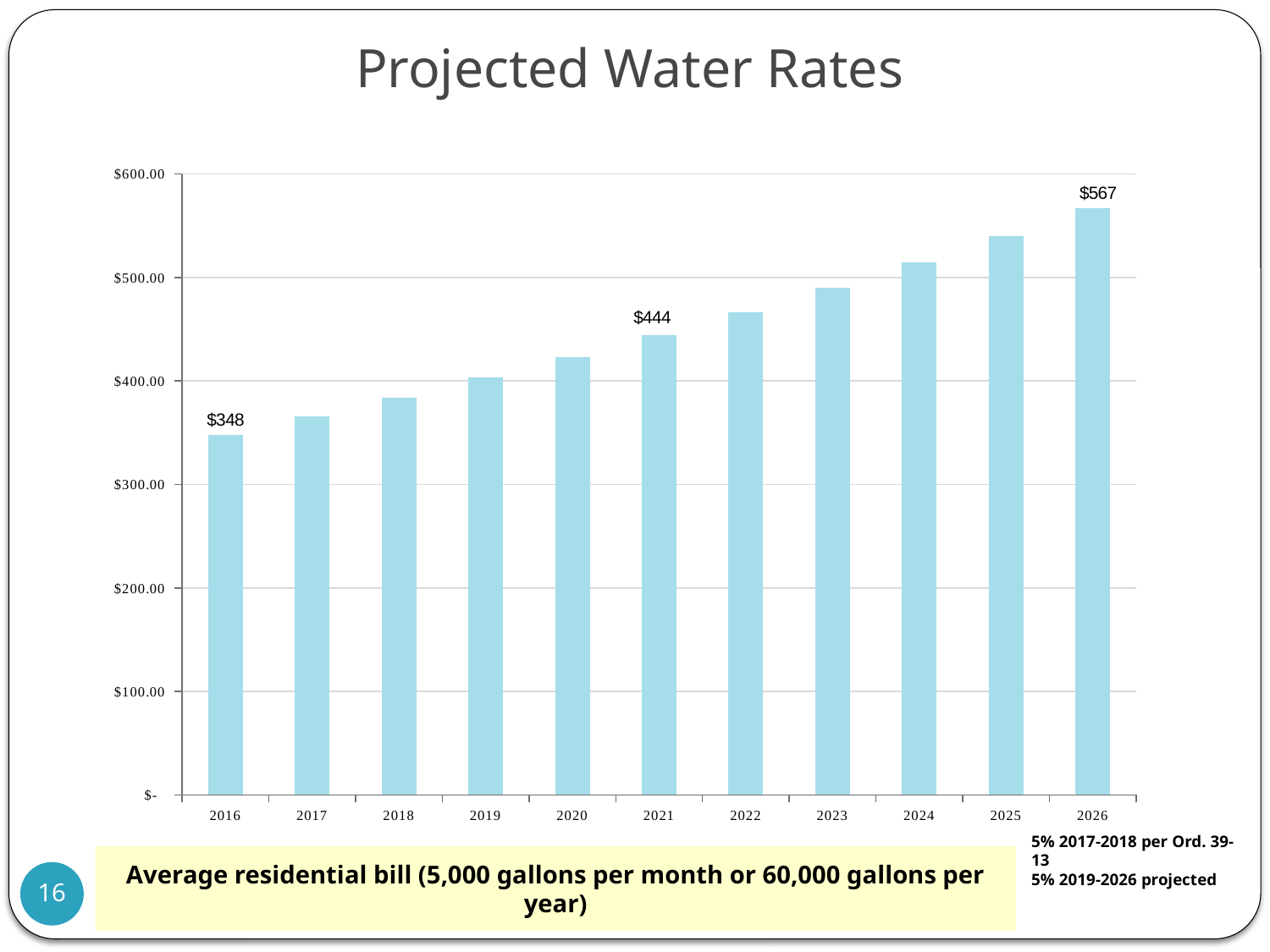
What is the difference between the values for 2026 and 2016? $219 How many years are shown on the x axis? 11 What is the value for 2016? $348 Which is larger, the value for 2019 or the value for 2023? 2023 What is the value for 2021? $444 What is the value for 2026? $567 Is the value for 2024 greater or less than $500.00? greater What is the difference between the values for 2021 and 2016? $96 What kind of chart is this? bar chart Which year has the highest value? 2026 Which year has the lowest value? 2016 Is the value for 2018 greater or less than $400.00? less